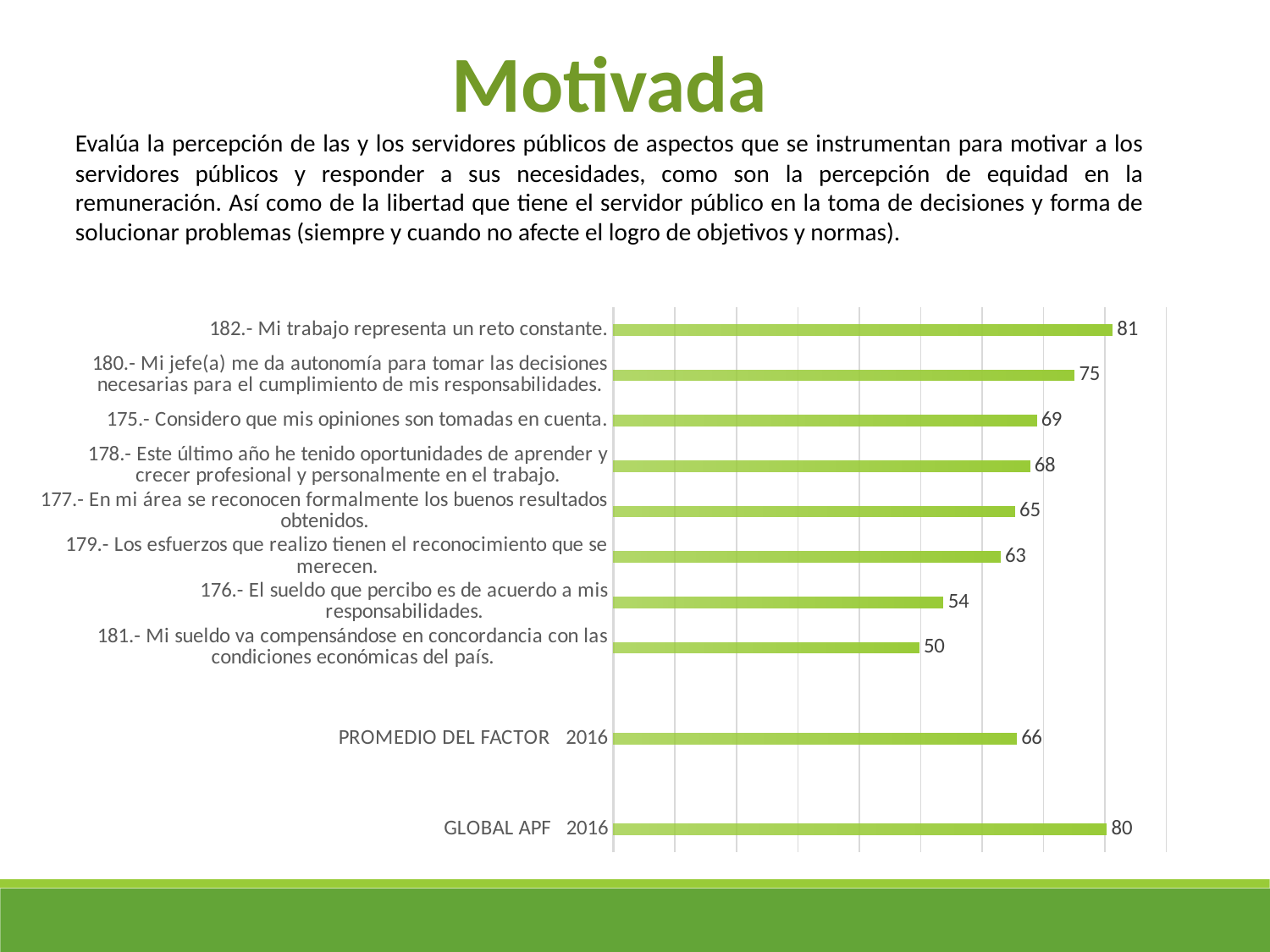
What is the value of PROMEDIO DEL FACTOR 2016? 66 What is the difference between the value for item 182 and the value for item 181? 31 What value is shown for item 182 ("Mi trabajo representa un reto constante")? 81 What is the difference between GLOBAL APF 2016 and PROMEDIO DEL FACTOR 2016? 14 What is the title of the slide? Motivada Which item has the highest value in the chart? 182.- Mi trabajo representa un reto constante. Which is larger: the value for item 180 or the value for item 175? Item 180 What value is shown for item 181 ("Mi sueldo va compensándose en concordancia con las condiciones económicas del país")? 50 How many bars are plotted in the chart? 10 What kind of chart is shown on the slide? Bar chart Which item has the lowest value in the chart? 181.- Mi sueldo va compensándose en concordancia con las condiciones económicas del país. What is the value of GLOBAL APF 2016? 80